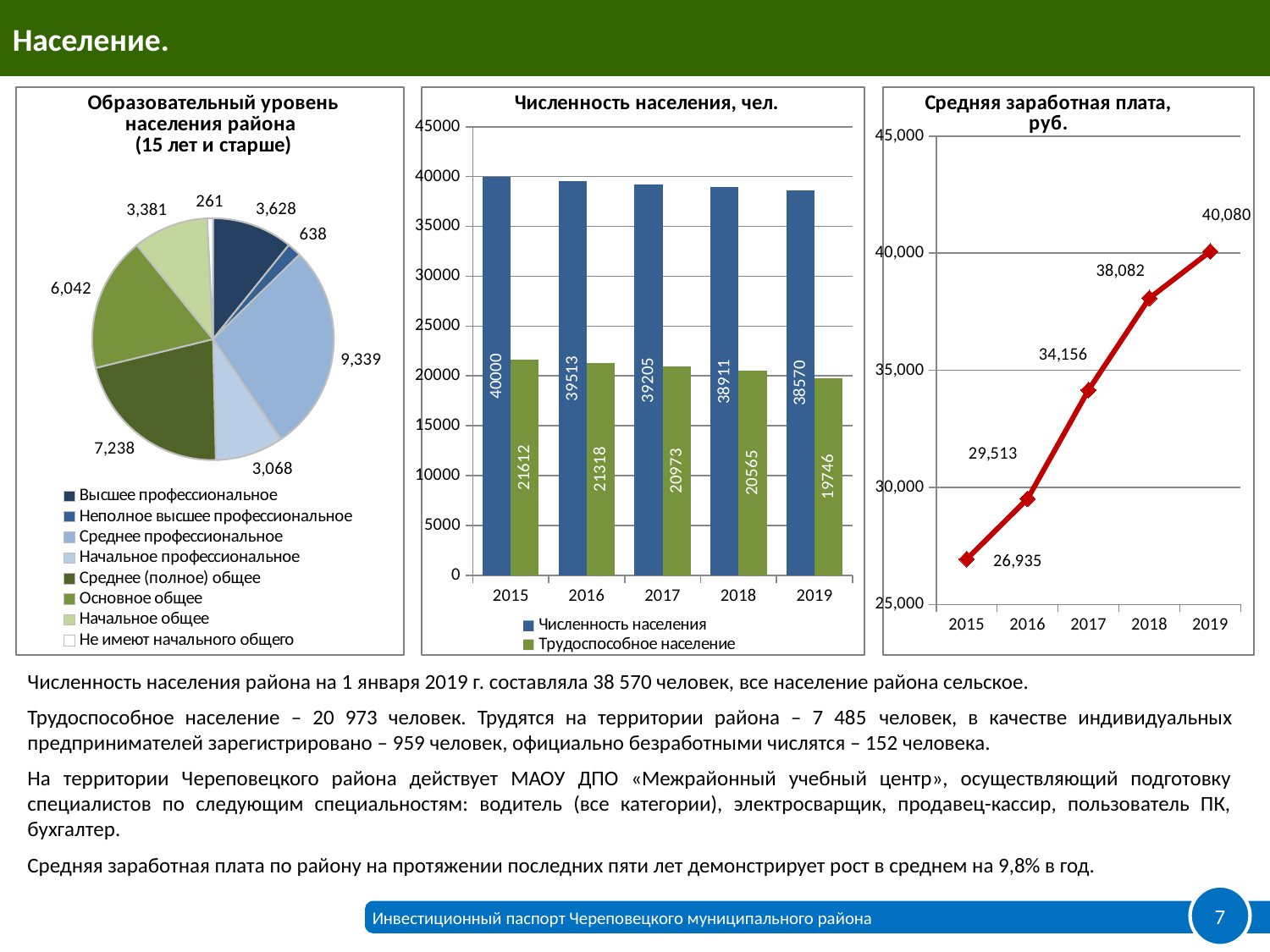
In the pie chart 'Образовательный уровень населения района', what is the value for 'Среднее профессиональное'? 9,339 In the chart 'Численность населения, чел.', does 'Численность населения' rise or fall from 2015 to 2019? fall In the chart 'Численность населения, чел.', what is the value of 'Численность населения' for 2019? 38570 In the chart 'Численность населения, чел.', what is the difference between 'Численность населения' in 2015 and in 2019? 1430 In the pie chart 'Образовательный уровень населения района', which category has the smallest value? Не имеют начального общего In the chart 'Средняя заработная плата, руб.', what is the value for 2017? 34,156 What kind of chart is 'Средняя заработная плата, руб.'? line chart In the pie chart 'Образовательный уровень населения района', how many categories does the legend list? 8 In the chart 'Численность населения, чел.', how many series does the legend list? 2 In the chart 'Численность населения, чел.', what is the value of 'Трудоспособное население' for 2017? 20973 In the chart 'Средняя заработная плата, руб.', what is the difference between the 2019 and 2015 values? 13,145 In the chart 'Средняя заработная плата, руб.', which year has the highest value? 2019